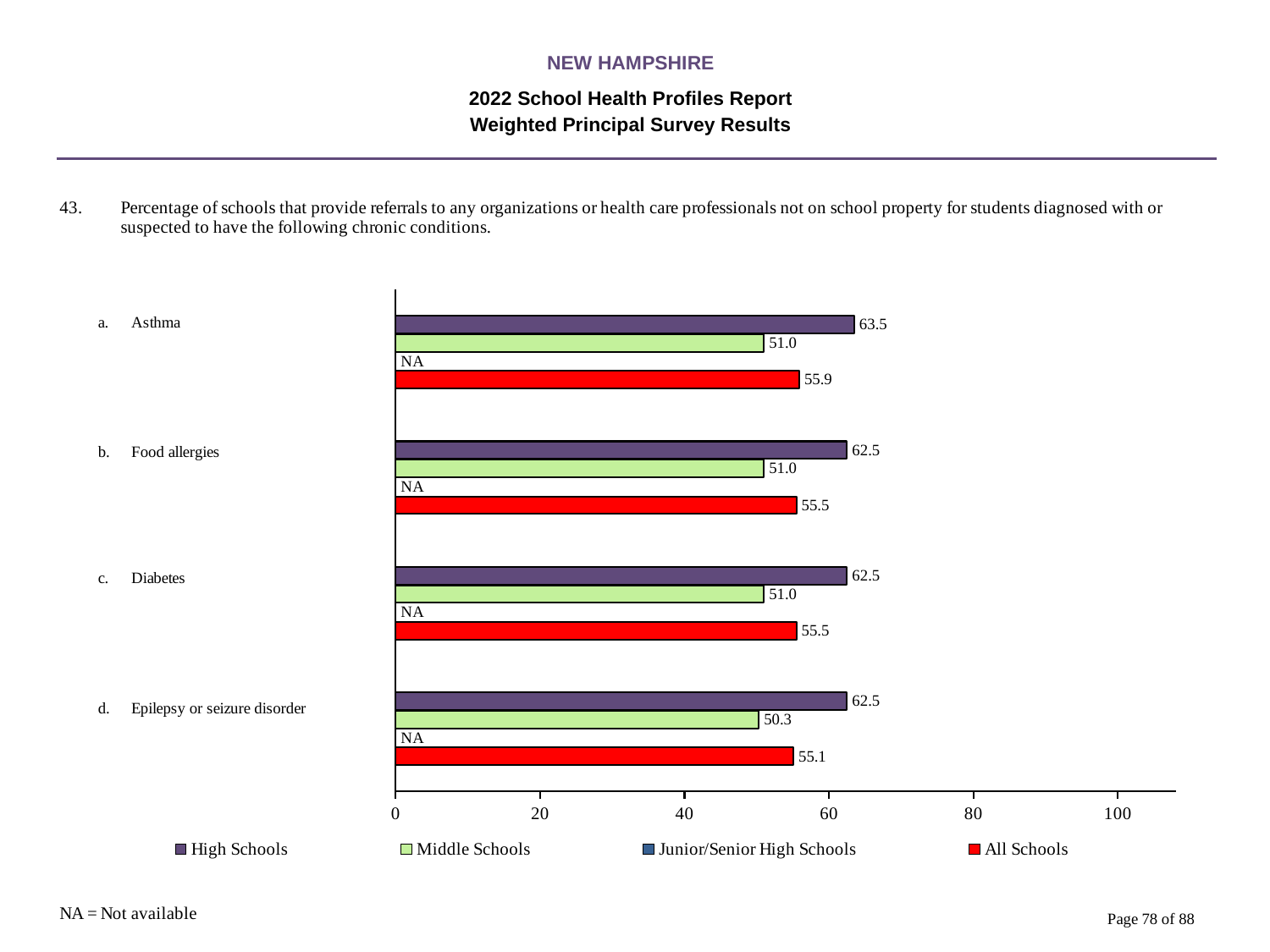
What is shown for Junior/Senior High Schools for Diabetes? NA Which condition has the highest value for High Schools? Asthma What does NA stand for according to the note on the slide? Not available How many series does the legend list? 4 Which is larger for Diabetes: the High Schools value or the All Schools value? High Schools Which condition has the lowest value for Middle Schools? Epilepsy or seizure disorder What is the value for Middle Schools for Food allergies? 51.0 What kind of chart is shown on the slide? Bar chart What is the difference between the High Schools and Middle Schools values for Asthma? 12.5 What is the value for High Schools for Asthma? 63.5 How many chronic conditions are listed on the chart? 4 What is the value for All Schools for Epilepsy or seizure disorder? 55.1